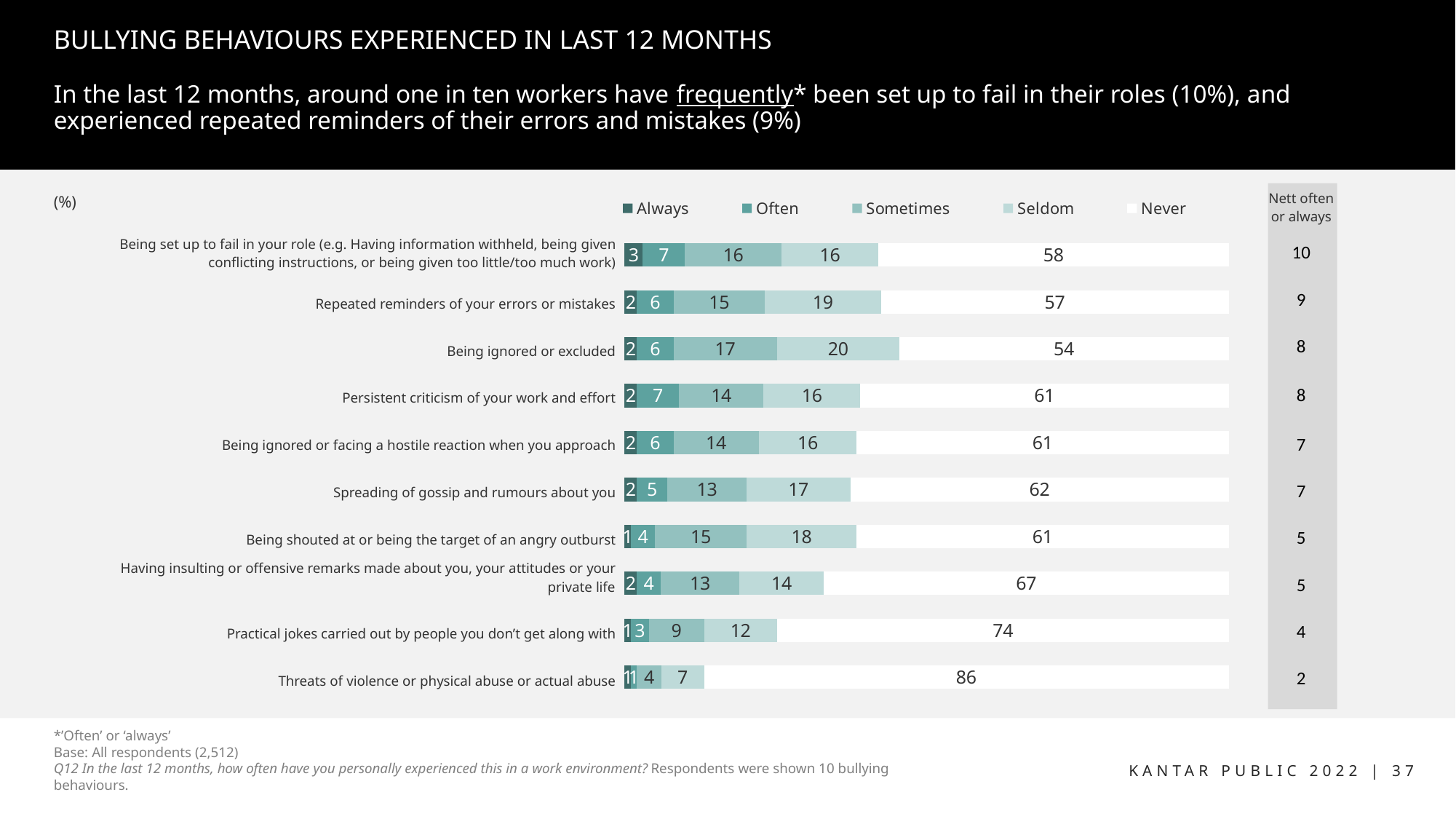
What is the difference between the 'Never' values for 'Threats of violence or physical abuse or actual abuse' and 'Practical jokes carried out by people you don't get along with'? 12 Which behaviour has the lowest 'Never' value? Being ignored or excluded What is the total of the stacked bar for 'Being set up to fail in your role'? 100 What kind of chart is shown on the slide? Stacked bar chart What is the 'Never' value for 'Threats of violence or physical abuse or actual abuse'? 86 Which has a larger 'Sometimes' value: 'Being ignored or excluded' or 'Persistent criticism of your work and effort'? Being ignored or excluded How many bullying behaviours (categories) are plotted in the chart? 10 How many series does the chart legend list? 5 What is the 'Seldom' value for 'Being ignored or excluded'? 20 What is the first entry listed in the chart legend? Always What is the 'Nett often or always' value for 'Repeated reminders of your errors or mistakes'? 9 Which behaviour has the highest 'Never' value? Threats of violence or physical abuse or actual abuse